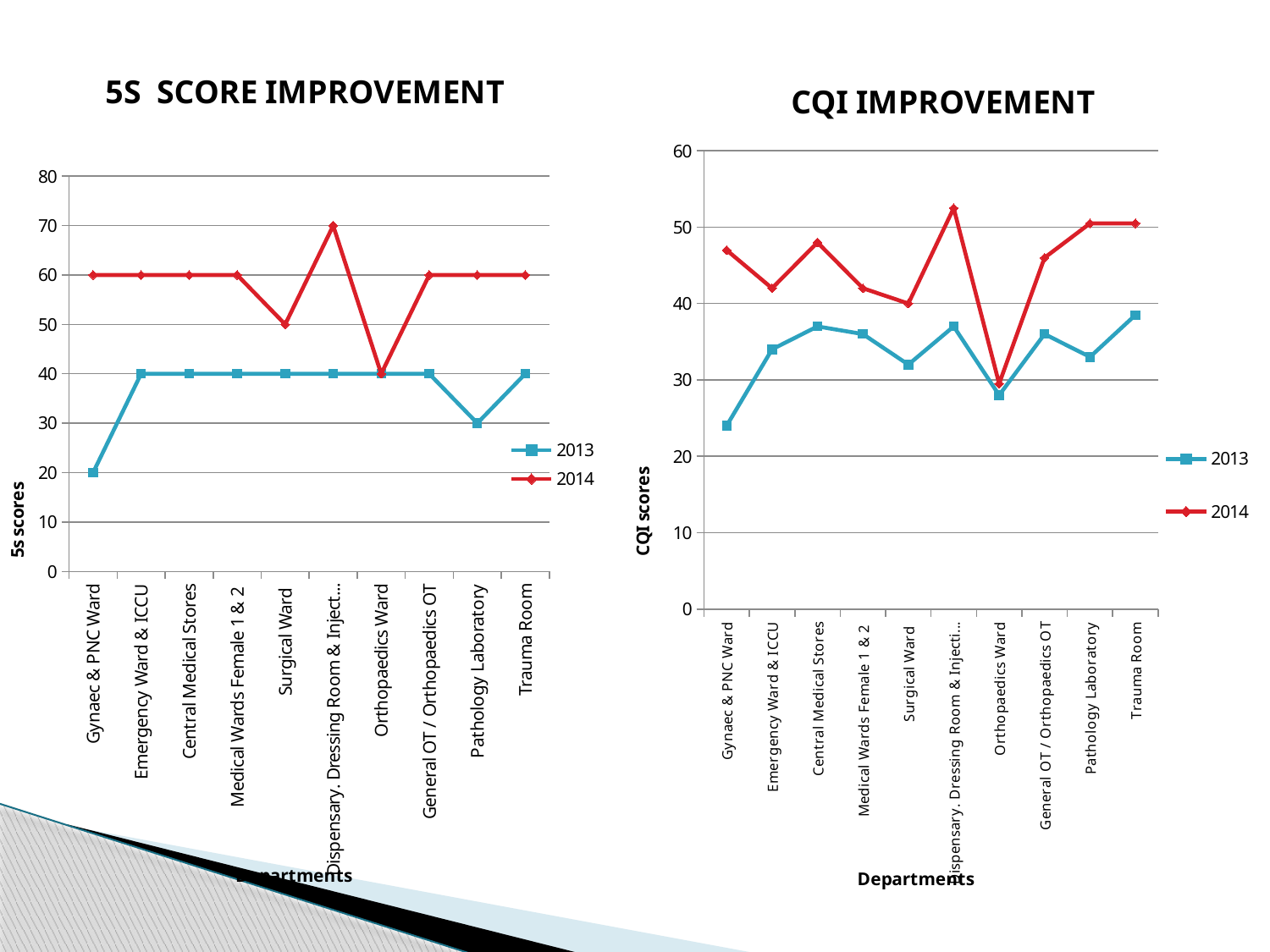
In the "5S SCORE IMPROVEMENT" chart, what is the 2013 value for Gynaec & PNC Ward? 20 In the "5S SCORE IMPROVEMENT" chart, what is the difference between the 2014 and 2013 values for Pathology Laboratory? 30 How many departments are shown on the x axis of the "5S SCORE IMPROVEMENT" chart? 10 In the "5S SCORE IMPROVEMENT" chart, what is the 2014 value for Orthopaedics Ward? 40 In the "CQI IMPROVEMENT" chart, is the 2014 value for Dispensary. Dressing Room & Injecti... greater or less than 50? greater In the "CQI IMPROVEMENT" chart, is the 2013 value for Gynaec & PNC Ward greater or less than 30? less What type of chart is the "5S SCORE IMPROVEMENT" chart? line chart In the "5S SCORE IMPROVEMENT" chart, which department has the highest 2014 value? Dispensary. Dressing Room & Inject... In the "CQI IMPROVEMENT" chart, which department has the lowest 2014 value? Orthopaedics Ward In the "5S SCORE IMPROVEMENT" chart, what is the 2014 value for Surgical Ward? 50 How many series does the legend of the "CQI IMPROVEMENT" chart list? 2 In the "5S SCORE IMPROVEMENT" chart, which department has the lowest 2013 value? Gynaec & PNC Ward